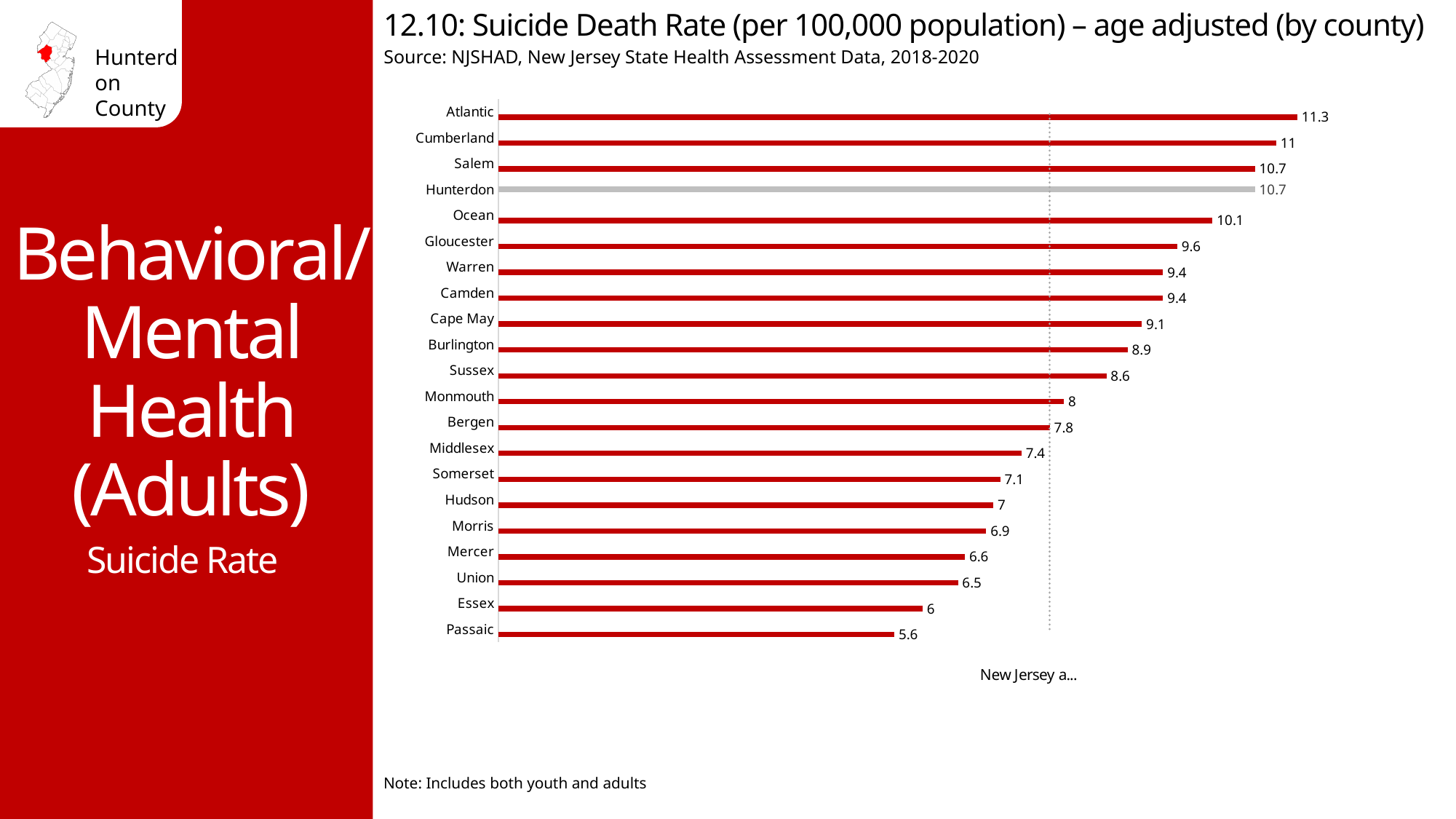
Which county has a higher suicide death rate, Gloucester or Sussex? Gloucester What is the difference between the suicide death rates of Hunterdon and Bergen counties? 2.9 Which county has the lowest suicide death rate? Passaic What is the suicide death rate for Cumberland County? 11 How many counties are shown in the chart? 21 What is the suicide death rate for Passaic County? 5.6 What is the suicide death rate for Ocean County? 10.1 What is the suicide death rate for Hunterdon County? 10.7 Which county's bar is shown in grey rather than red? Hunterdon What kind of chart is shown on the slide? Bar chart Which county has the highest suicide death rate? Atlantic What is the difference between the suicide death rates of Atlantic and Passaic counties? 5.7